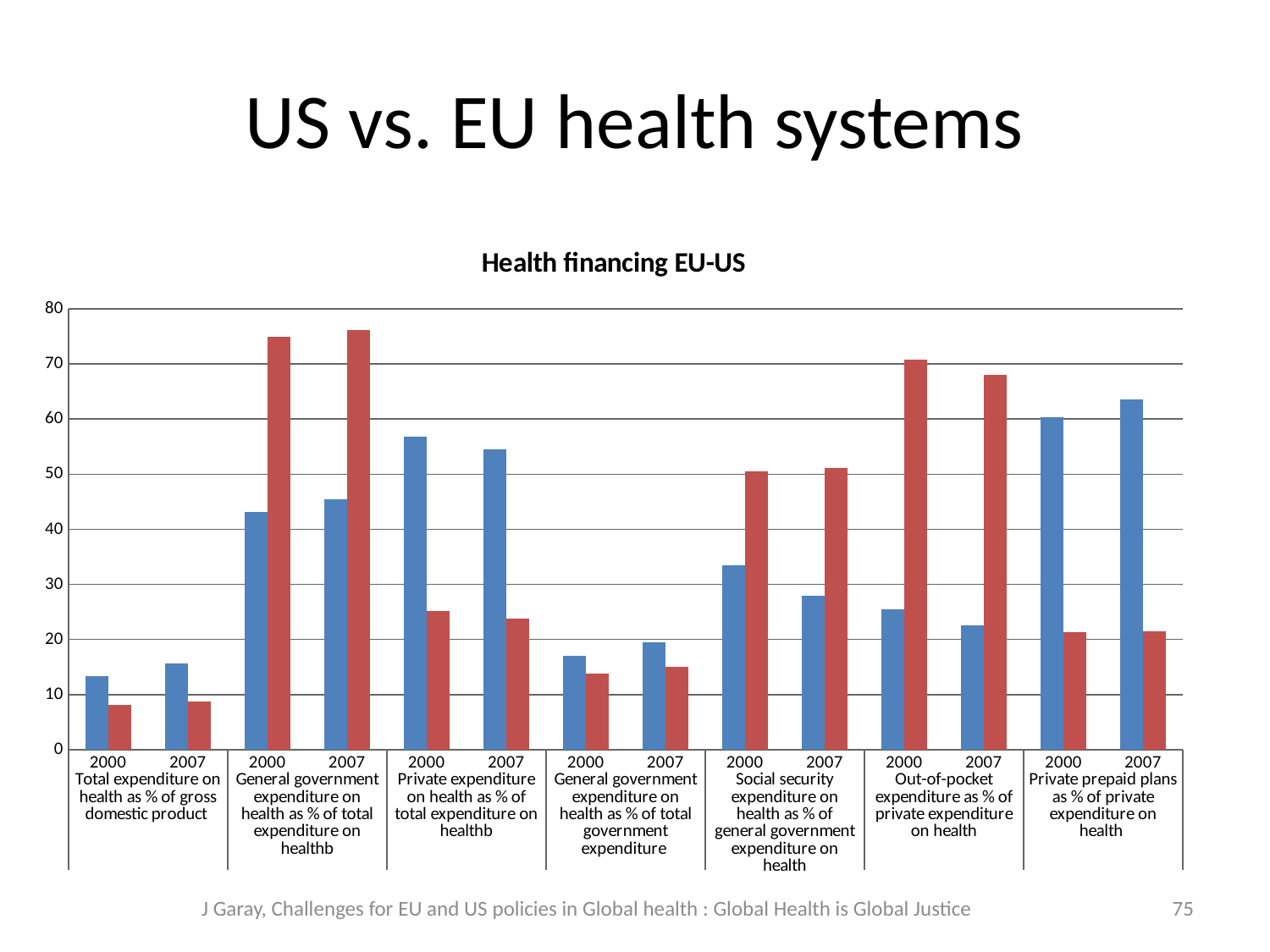
Which indicator group contains the tallest bar in the chart? General government expenditure on health as % of total expenditure on healthb What is the title of the chart? Health financing EU-US For 2000 under 'Private expenditure on health as % of total expenditure on healthb', which bar is taller, the blue or the red? blue What type of chart is shown on the slide? bar chart How many differently coloured bar series are plotted in the chart? 2 Is the red bar for 2000 under 'Total expenditure on health as % of gross domestic product' greater or less than 10? less How many expenditure indicator groups are shown along the x axis of the chart? 7 Is the blue bar for 2000 under 'General government expenditure on health as % of total government expenditure' greater or less than 20? less Is the blue bar for 2000 under 'Private prepaid plans as % of private expenditure on health' greater or less than 50? greater For 2007 under 'Out-of-pocket expenditure as % of private expenditure on health', which bar is taller, the blue or the red? red